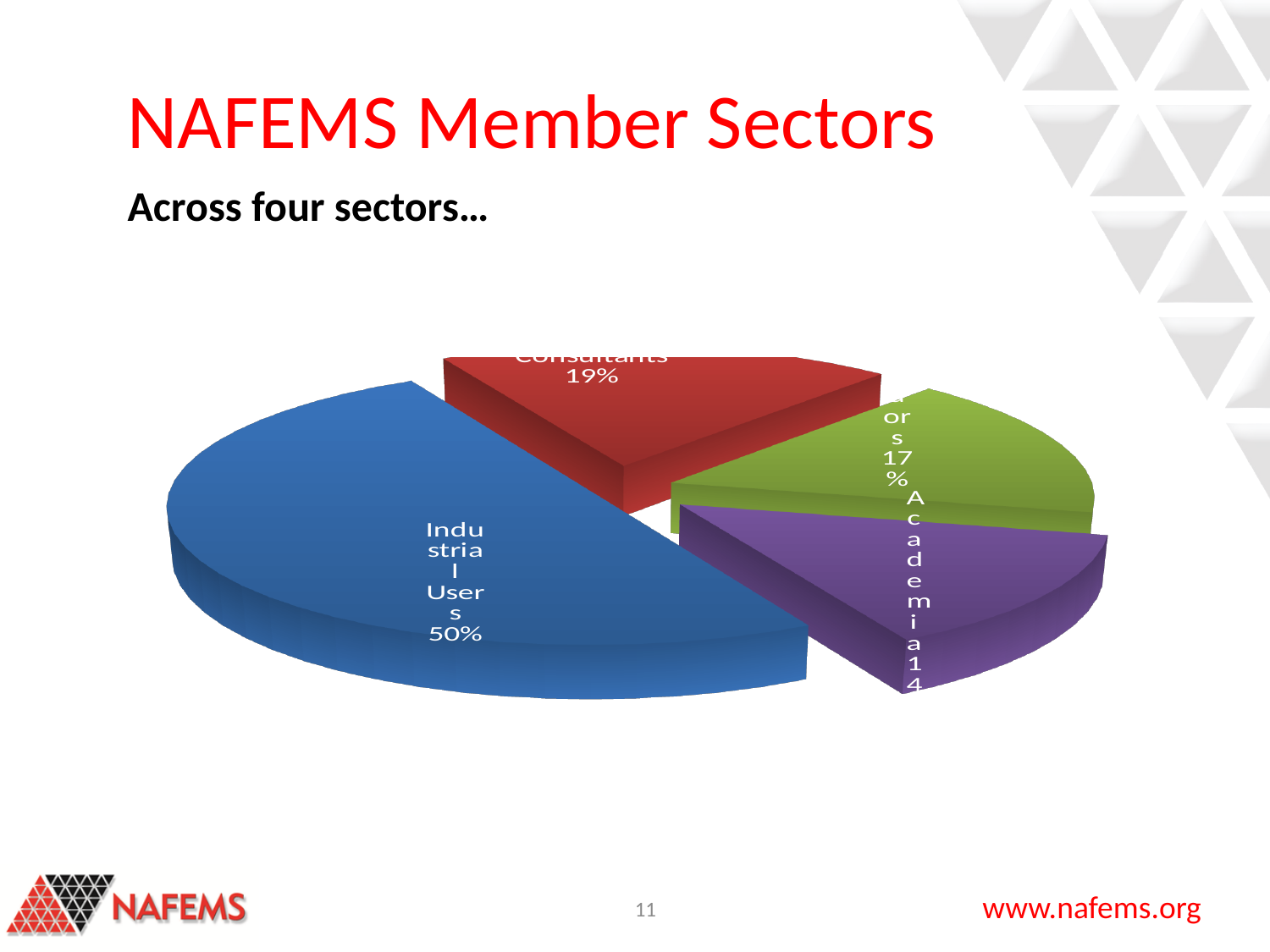
What share of the pie do Industrial Users account for? 50% Which is larger, the share for Industrial Users or the share for Consultants? Industrial Users Which sector has the largest share of the pie? Industrial Users What percentage of NAFEMS members are Consultants? 19% What percentage of NAFEMS members are Industrial Users? 50% Which sector has the smallest share of the pie? Academia What is the title of the slide containing the pie chart? NAFEMS Member Sectors How many sectors (slices) does the pie chart show? 4 By how many percentage points does the Industrial Users share exceed the Consultants share? 31 percentage points Which is larger, the share for Consultants or the share for Academia? Consultants What colour is the Industrial Users slice? blue What kind of chart is shown on the slide? pie chart